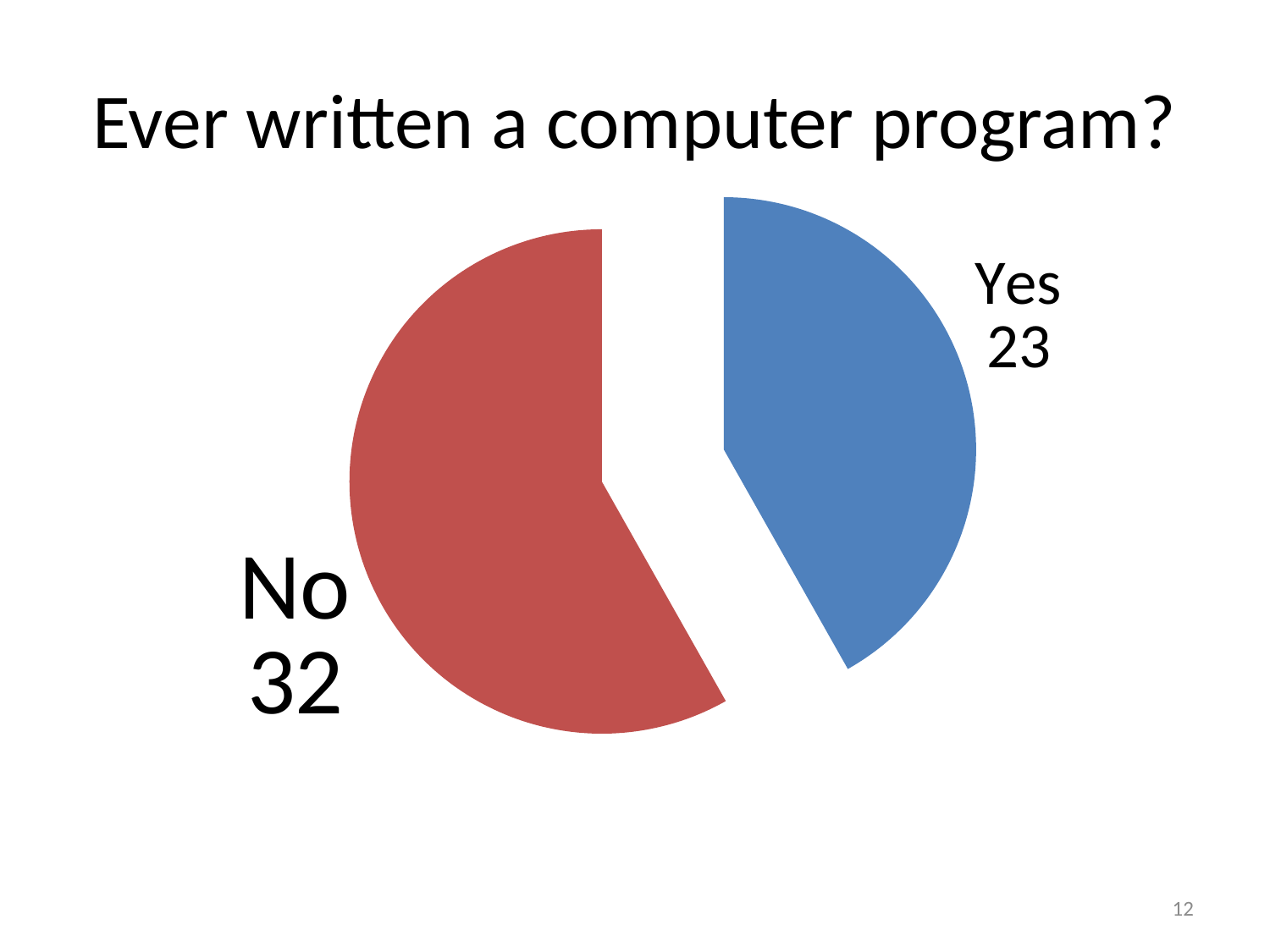
Which category has the highest value? No How many slices does the pie chart have? 2 What is the value for Yes? 23 What is the title of the chart? Ever written a computer program? What is the value for No? 32 What kind of chart is shown on the slide? pie chart What is the total of all slices in the pie chart? 55 Which category has the lowest value? Yes Which is larger, the value for Yes or the value for No? No What is the difference between the values for No and Yes? 9 What colour is the No slice? red